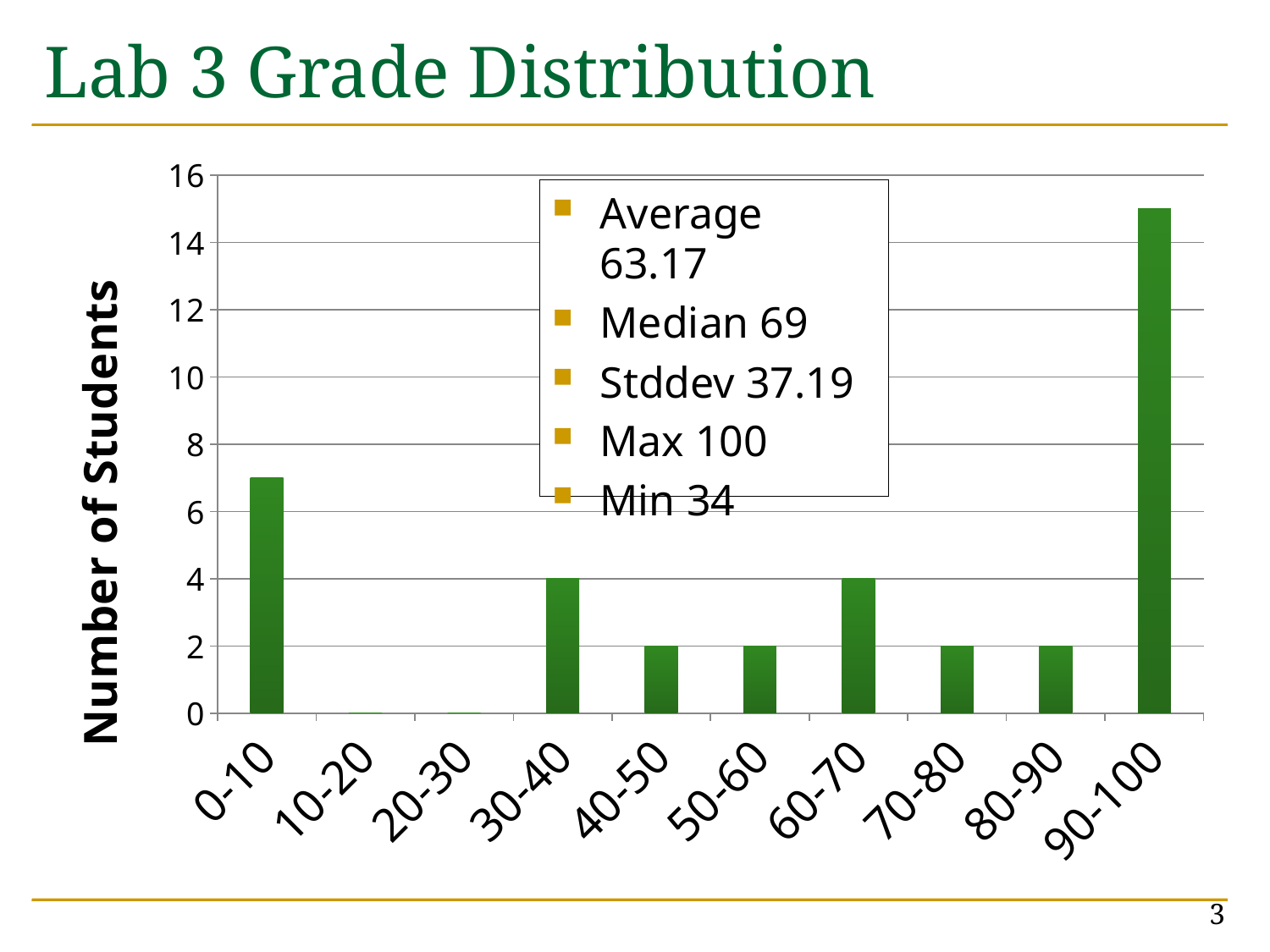
How many students are in the 60-70 grade range? 4 What is the difference between the number of students in the 30-40 range and the 40-50 range? 2 What is the title of the slide's chart? Lab 3 Grade Distribution Which has more students, the 0-10 range or the 90-100 range? 90-100 Which grade range has the highest number of students? 90-100 How many students are in the 30-40 grade range? 4 What kind of chart is shown on the slide? bar chart How many grade ranges are shown along the x axis? 10 What is the label on the vertical axis of the chart? Number of Students Is the number of students in the 0-10 range greater or less than 6? greater How many students are in the 40-50 grade range? 2 Is the number of students in the 90-100 range greater or less than 14? greater